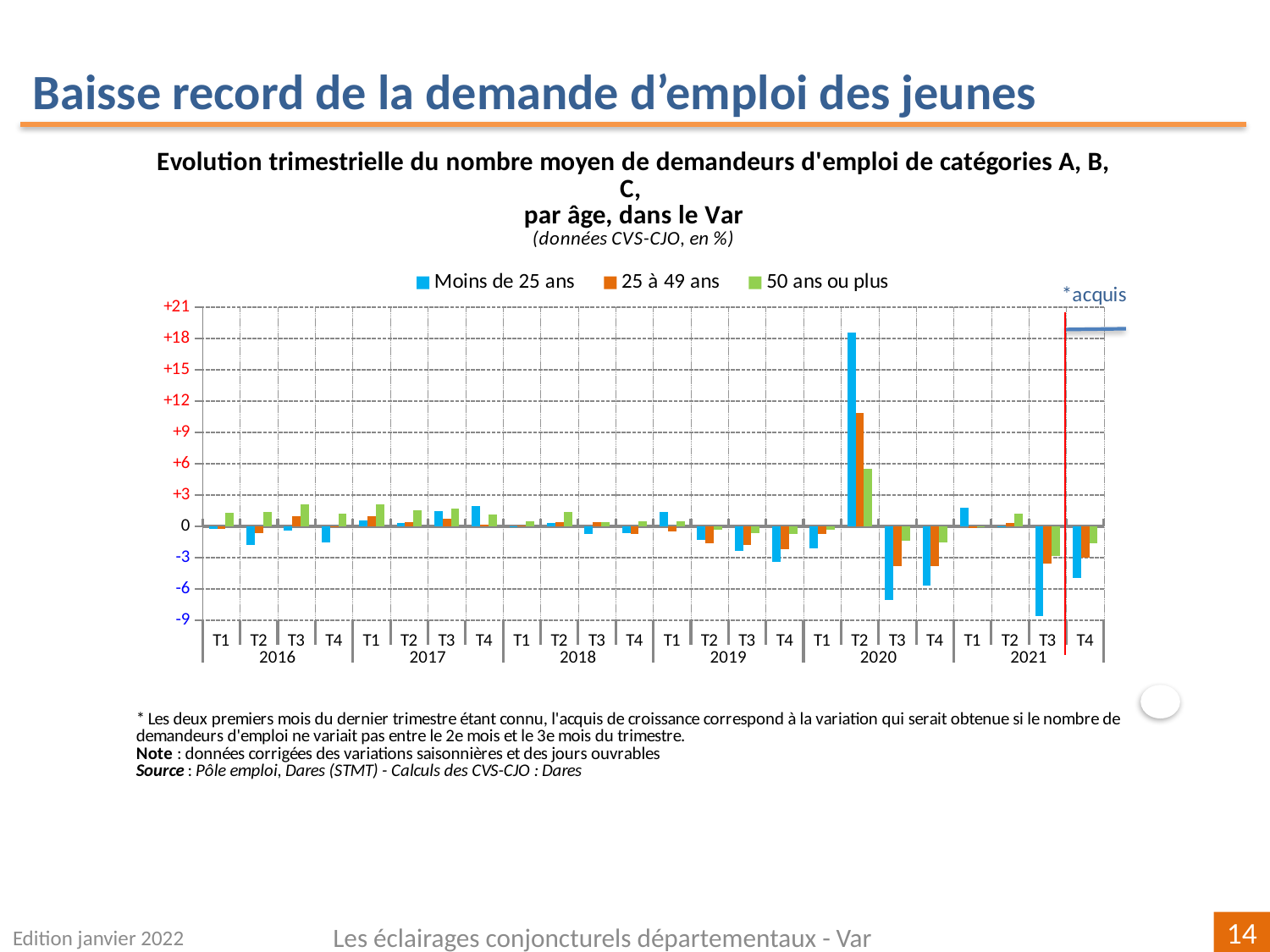
Which series shows the largest decline in T3 2021? Moins de 25 ans What colour represents the 'Moins de 25 ans' series? blue Is the value for '25 à 49 ans' in T2 2020 greater or less than +9? greater How many years are shown along the x axis? 6 Is the value for 'Moins de 25 ans' in T3 2021 greater or less than -6? less How many series does the legend list? 3 Is the value for '50 ans ou plus' in T2 2020 greater or less than +3? greater In T2 2020, which is larger: the value for 'Moins de 25 ans' or for '25 à 49 ans'? Moins de 25 ans In which quarter does the 'Moins de 25 ans' series reach its lowest value? T3 2021 What kind of chart is shown on the slide? bar chart In which quarter does the 'Moins de 25 ans' series reach its highest value? T2 2020